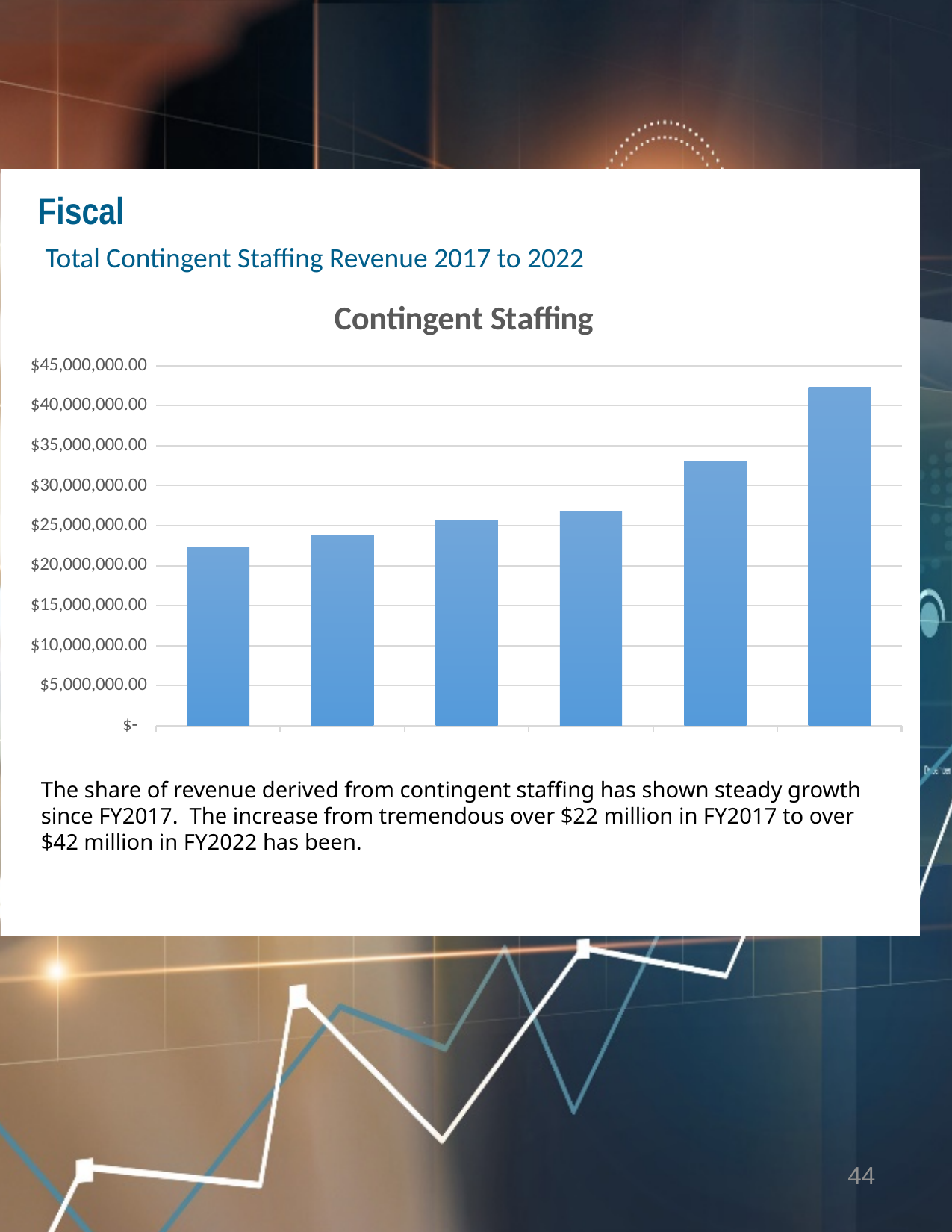
Is the value of the second bar from the left greater or less than $25,000,000.00? less What kind of chart is shown on the slide? Bar chart Do the bar values rise or fall from left to right across the chart? Rise Is the value of the fifth bar from the left greater or less than $30,000,000.00? greater Which bar is the tallest in the chart? The rightmost (sixth) bar Which bar is the shortest in the chart? The leftmost (first) bar How many bars are plotted in the chart? 6 What is the title of the chart? Contingent Staffing Is the value of the leftmost bar greater or less than $20,000,000.00? greater Which is larger, the value of the rightmost bar or the value of the leftmost bar? The rightmost bar What is the highest value shown on the vertical axis of the chart? $45,000,000.00